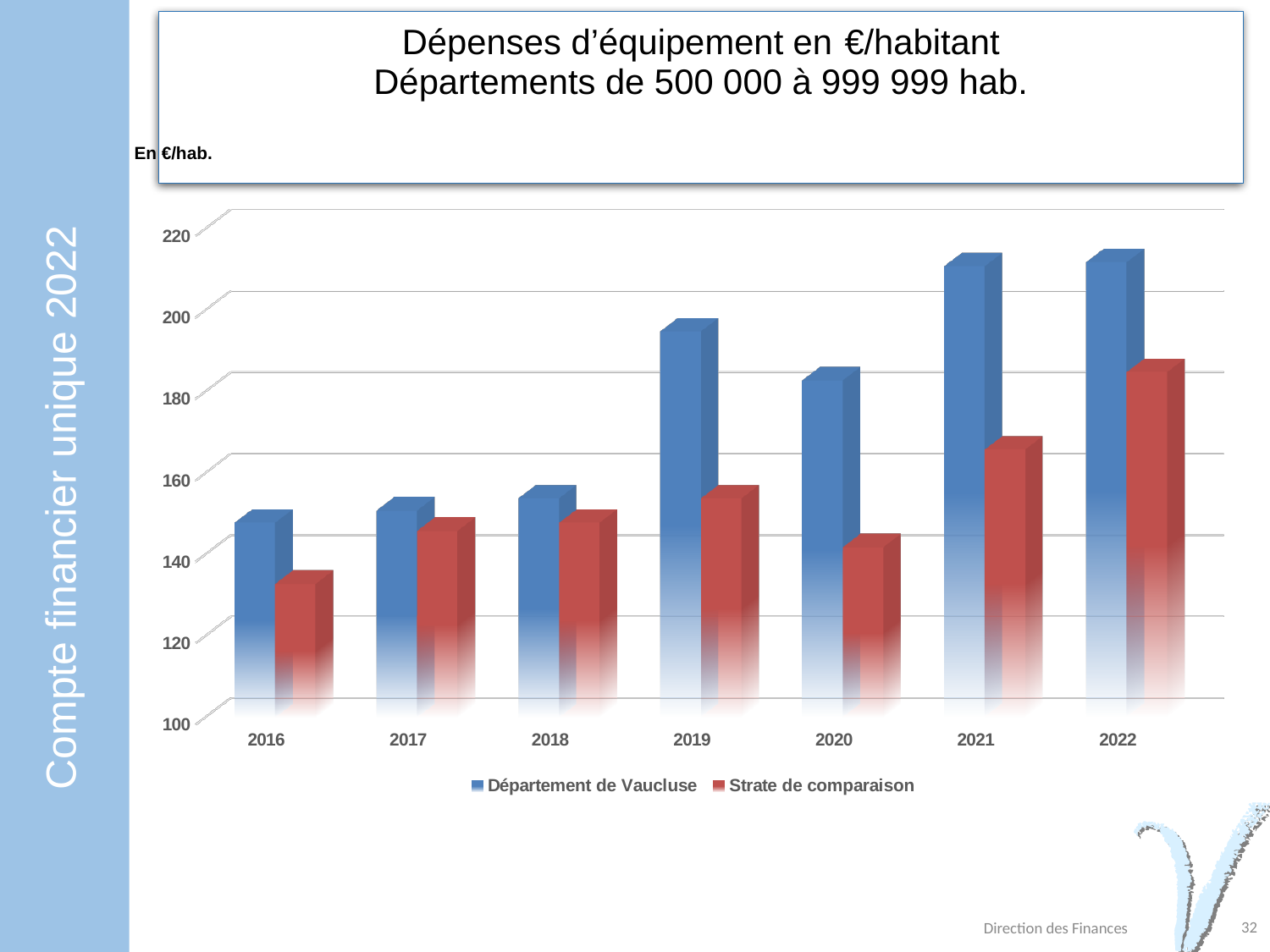
For Strate de comparaison, which year has the highest value? 2022 Which series are listed in the chart legend? Département de Vaucluse and Strate de comparaison Is the value for Strate de comparaison in 2020 greater or less than 160? less Is the value for Département de Vaucluse in 2019 greater or less than 180? greater How many series does the legend list? 2 Is the value for Département de Vaucluse in 2021 greater or less than 200? greater Do the values for Strate de comparaison rise or fall from 2020 to 2022? rise How many years are shown on the x axis of the chart? 7 What kind of chart is shown on the slide? Bar chart For Strate de comparaison, which year has the lowest value? 2016 In 2019, which is larger: Département de Vaucluse or Strate de comparaison? Département de Vaucluse